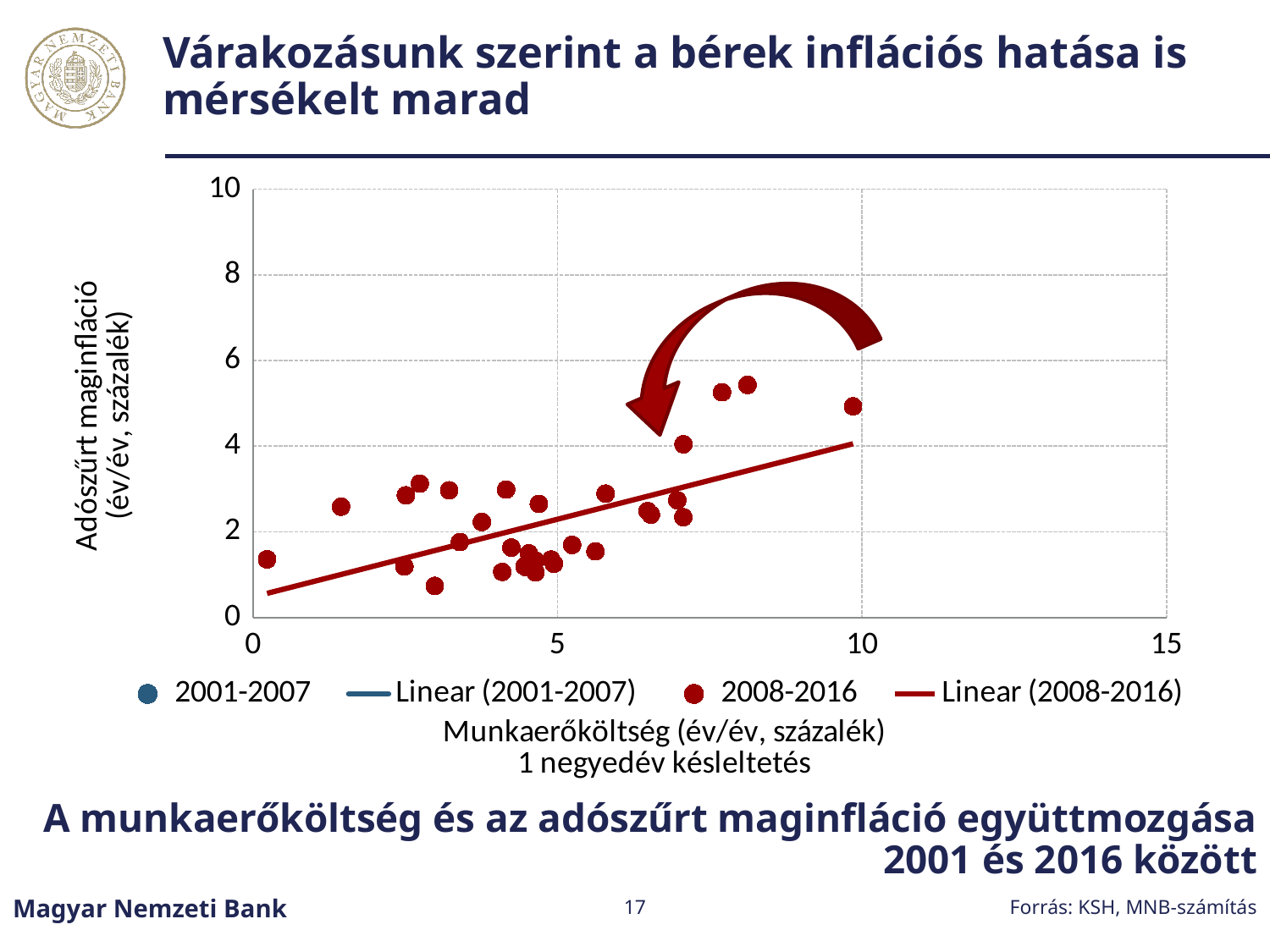
How many entries does the chart legend list? 4 Does the 'Linear (2008-2016)' trend line rise or fall as the x-axis value increases? rises What is the maximum value shown on the chart's vertical axis? 10 What is the title of the chart's horizontal axis? Munkaerőköltség (év/év, százalék) 1 negyedév késleltetés What is the maximum value shown on the chart's horizontal axis? 15 Which legend series is plotted with red dots? 2008-2016 Is the vertical-axis value of the highest plotted 2008-2016 point greater or less than 5? greater What kind of chart is shown on the slide? scatter chart What is the title of the chart's vertical axis? Adószűrt maginfláció (év/év, százalék) Are any plotted points shown with a vertical-axis value above 8? No Is the horizontal-axis value of the rightmost 2008-2016 point greater or less than 8? greater